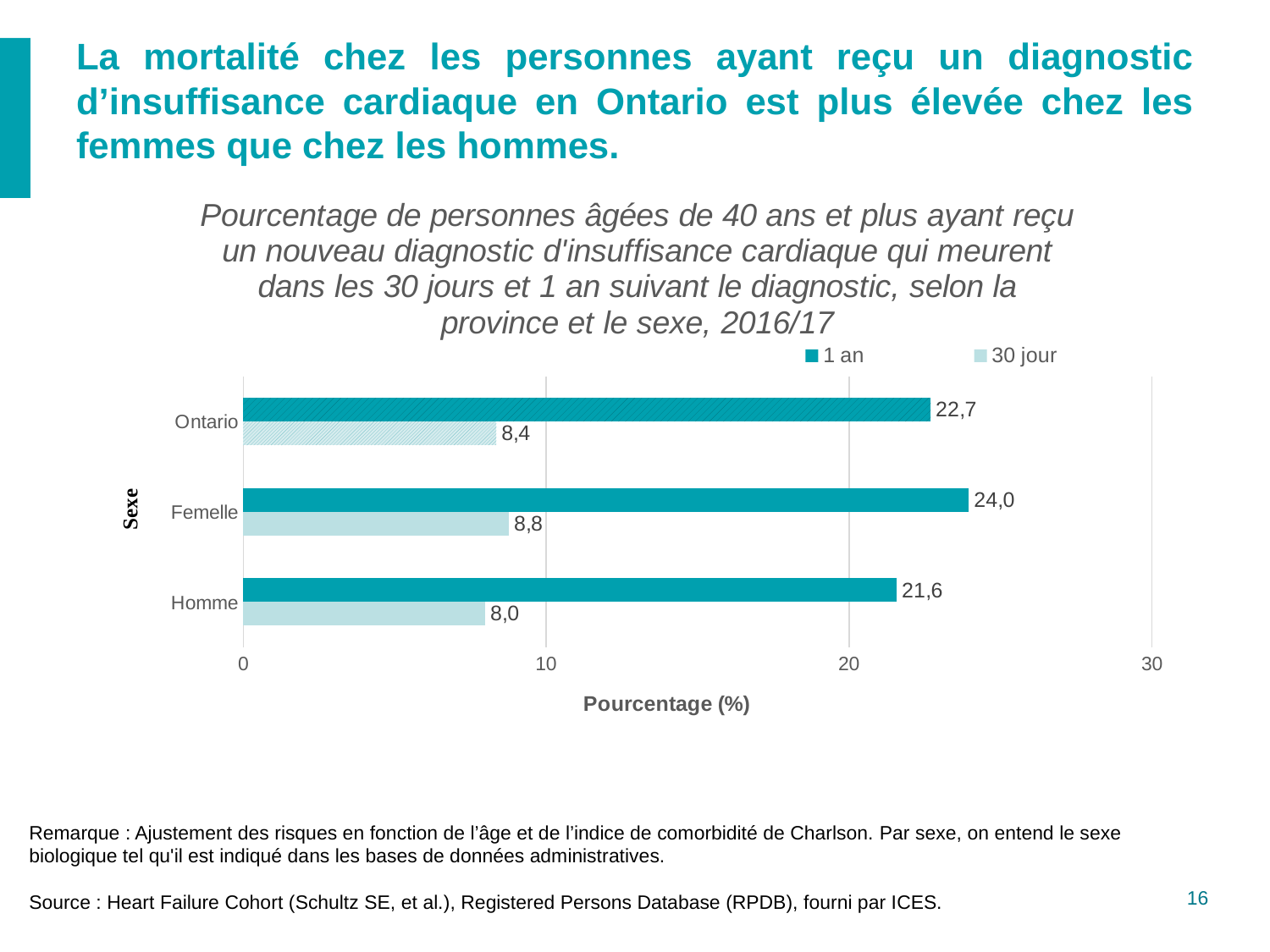
How many categories are shown on the y axis? 3 Which category has the lowest 30 jour value? Homme Which category has the highest 1 an value? Femelle What is the difference between the 1 an values for Femelle and Homme? 2,4 What is the 30 jour value for Homme? 8,0 How many series does the legend list? 2 What kind of chart is shown on the slide? bar chart Is the 1 an value for Homme greater or less than 20? greater Which is larger, the 30 jour value for Femelle or for Ontario? Femelle What is the 1 an value for Femelle? 24,0 What is the label of the x axis? Pourcentage (%) What is the 1 an value for Ontario? 22,7